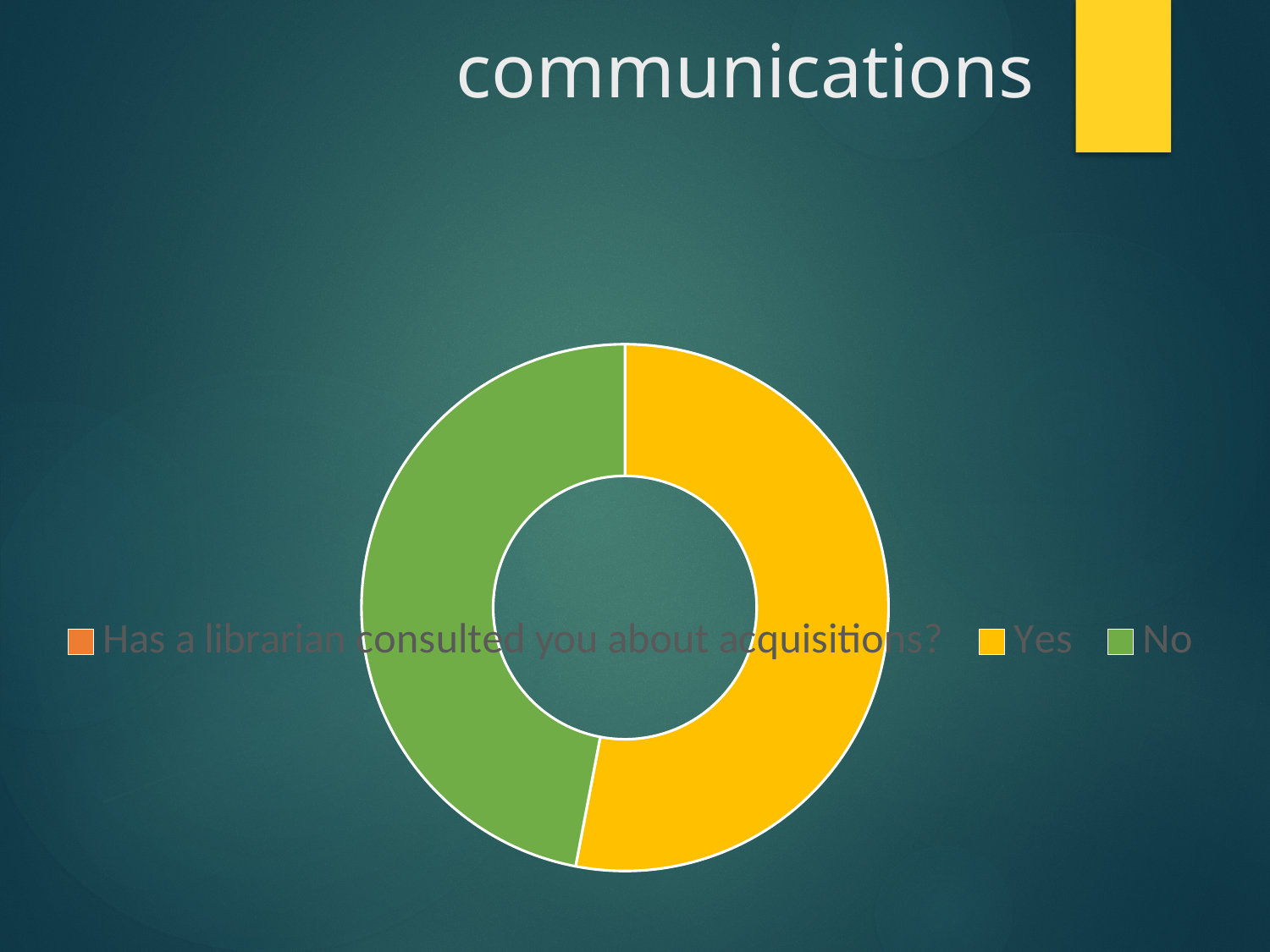
What kind of chart is shown on the slide? Doughnut chart How many slices are visible in the doughnut chart? 2 Is the No slice greater or less than half of the doughnut? less Which legend entry has the smallest visible slice in the doughnut chart? No How many entries does the legend list? 3 What colour is the Yes slice? Yellow Which slice is larger, Yes or No? Yes Is the Yes slice greater or less than half of the doughnut? greater What colour is the No slice? Green Which legend entry has the largest slice in the doughnut chart? Yes